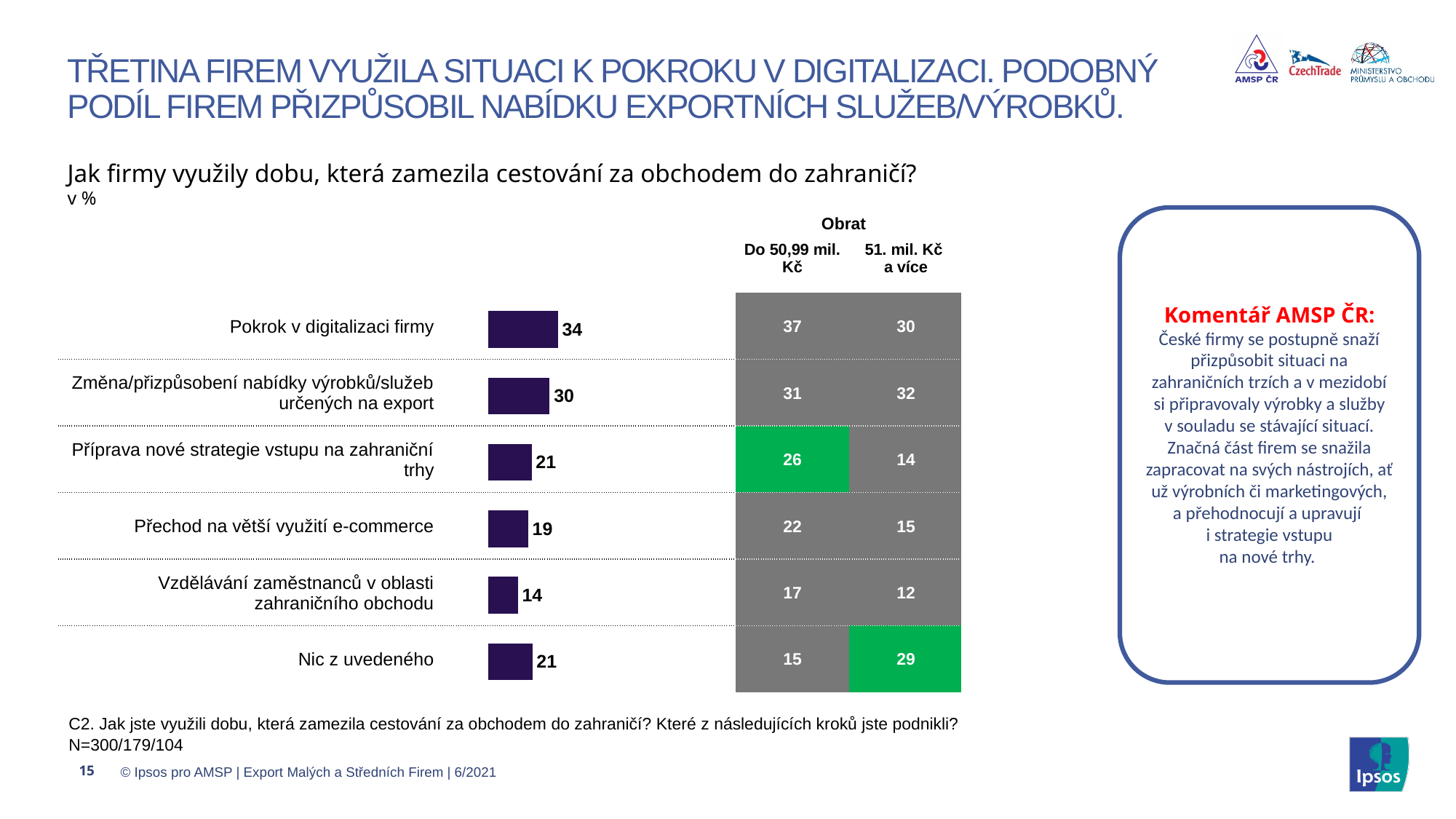
Which is larger: the value for "Příprava nové strategie vstupu na zahraniční trhy" or the value for "Přechod na větší využití e-commerce"? Příprava nové strategie vstupu na zahraniční trhy Which category has the lowest value in the bar chart? Vzdělávání zaměstnanců v oblasti zahraničního obchodu What kind of chart is shown on the slide? Bar chart What unit is stated for the values in the chart? v % In the Obrat table, what is the value for "Nic z uvedeného" in the "51. mil. Kč a více" column? 29 Which category has the highest value in the bar chart? Pokrok v digitalizaci firmy What is the value for "Pokrok v digitalizaci firmy" in the bar chart? 34 What is the value for "Vzdělávání zaměstnanců v oblasti zahraničního obchodu" in the bar chart? 14 What is the value for "Přechod na větší využití e-commerce" in the bar chart? 19 How many categories are shown in the bar chart? 6 What is the value for "Nic z uvedeného" in the bar chart? 21 What is the difference between the values for "Pokrok v digitalizaci firmy" and "Změna/přizpůsobení nabídky výrobků/služeb určených na export"? 4